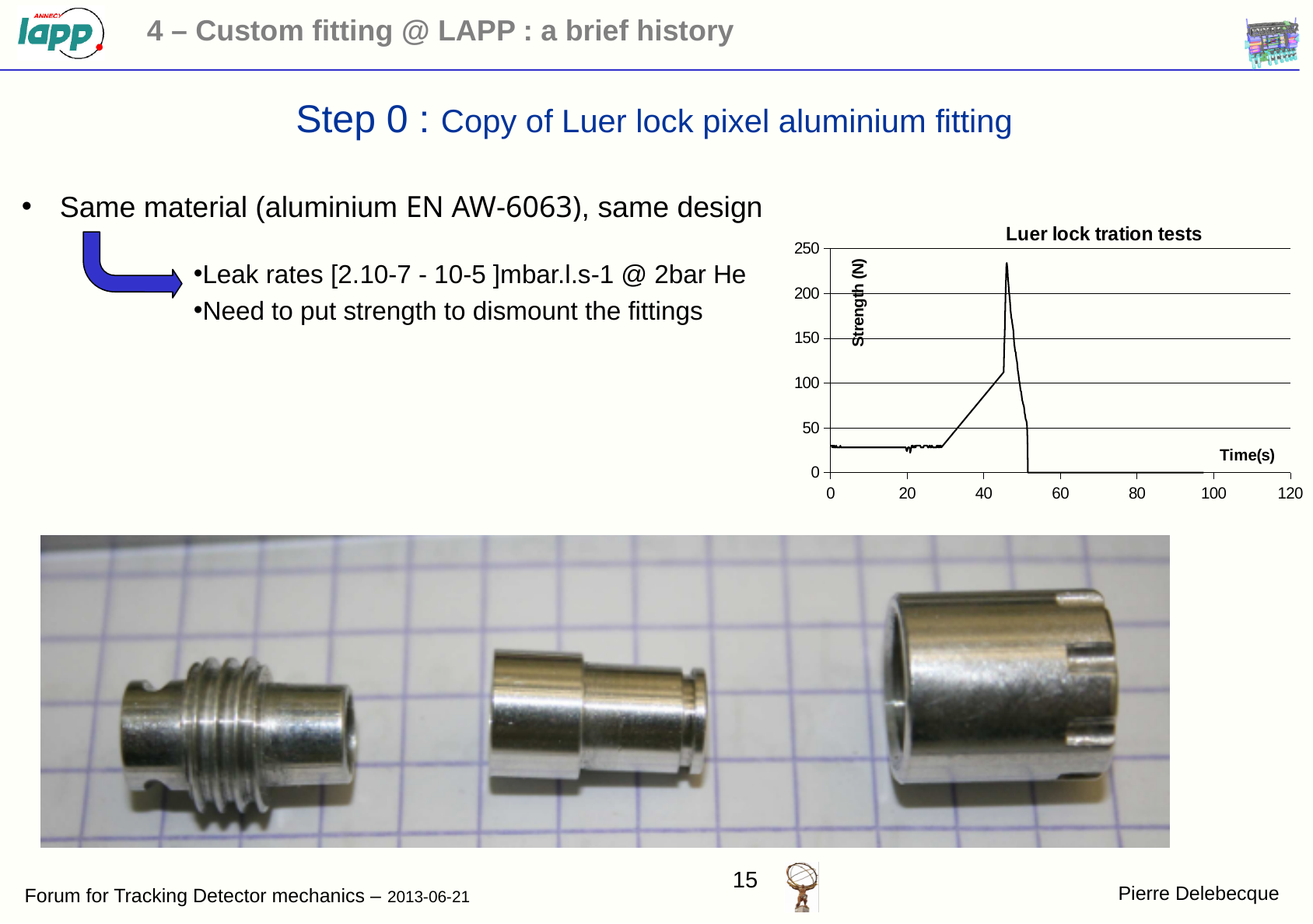
Is the strength at time 80 s greater or less than 50? less Is the strength at time 10 s greater or less than 50? less Is the peak strength value in the chart greater or less than 250? less Between about 30 s and 45 s, does the strength rise or fall? rise What is the label of the vertical axis of the chart? Strength (N) What kind of chart is shown on the slide? line chart After the peak, does the strength rise or fall as time increases? fall What is the title of the chart? Luer lock tration tests How many data series are plotted in the chart? 1 Is the strength at 20 s larger or smaller than the strength at 40 s? smaller